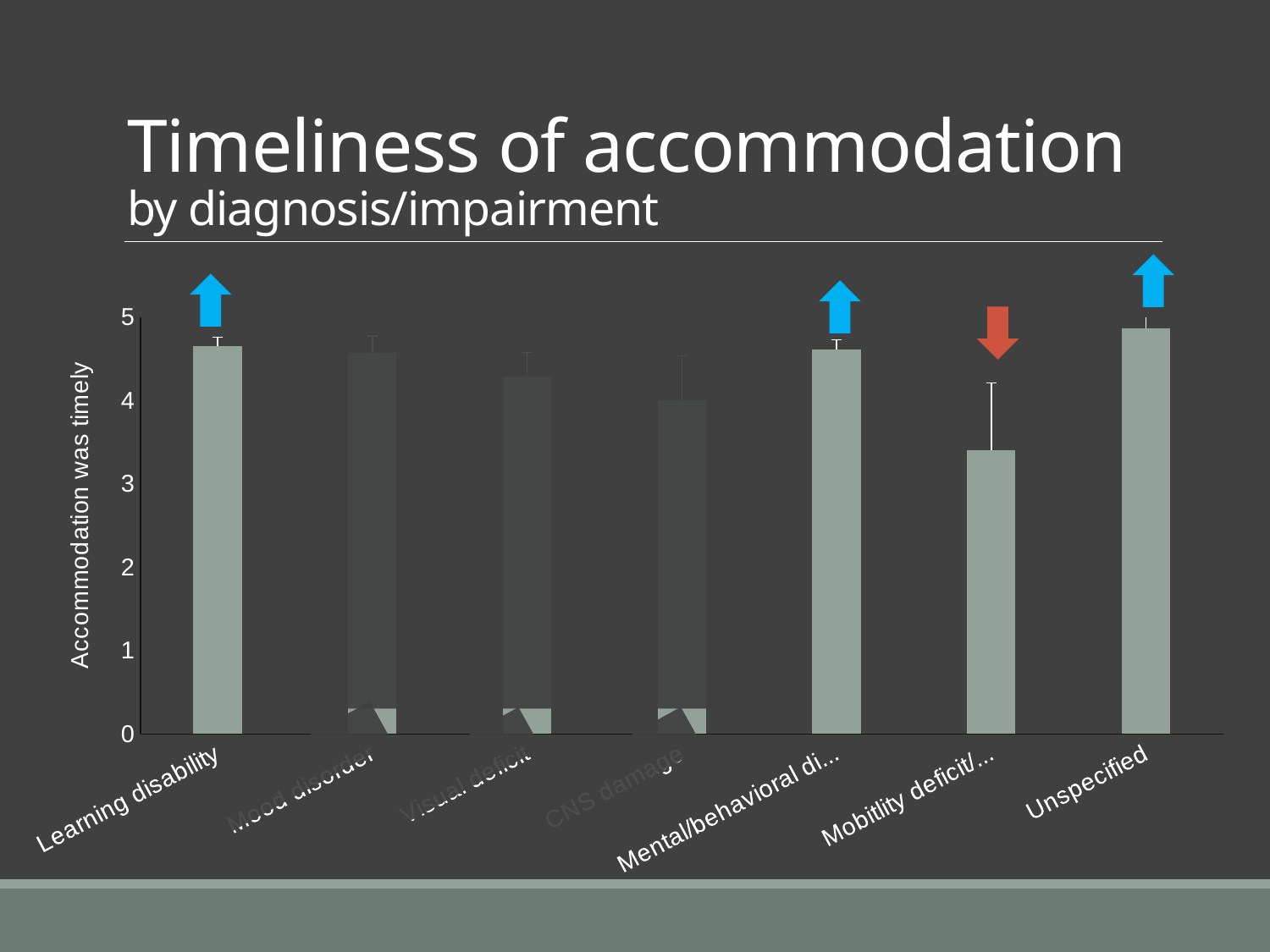
How many bars (categories) are plotted in the chart? 7 Is the value for Mobitlity deficit/... greater or less than 4? less Which category has a red downward arrow above its bar? Mobitlity deficit/... Is the value for Mobitlity deficit/... greater or less than 3? greater What kind of chart is shown on the slide? bar chart Which category has the highest value in the chart? Unspecified Is the value for Unspecified greater or less than 4? greater What is the label on the vertical axis of the chart? Accommodation was timely Which category has the lowest value in the chart? Mobitlity deficit/... Which is larger, the value for Mental/behavioral di... or the value for Mobitlity deficit/...? Mental/behavioral di... Which is larger, the value for Learning disability or the value for Mobitlity deficit/...? Learning disability